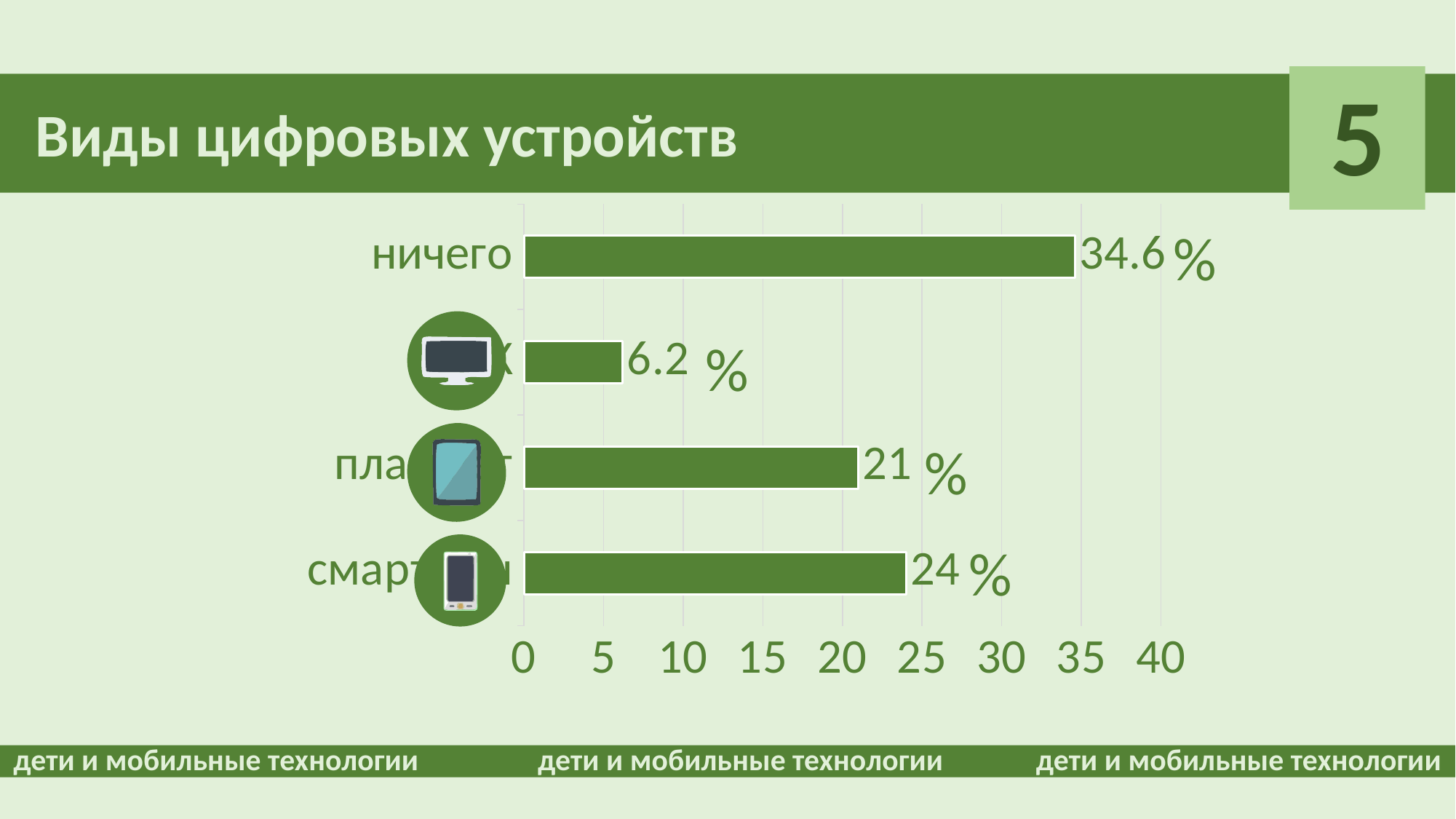
What is the difference between the values for смартфон and планшет? 3 % What is the value of the second bar from the top (the one with the computer monitor icon)? 6.2 % How many bars are shown on the chart? 4 What is the value for смартфон? 24 % What is the value for планшет? 21 % What is the lowest value shown on the chart? 6.2 % Which category has the highest value? ничего What is the value for ничего? 34.6 % Which is larger, the value for планшет or the value for смартфон? смартфон What is the title of the slide? Виды цифровых устройств What kind of chart is shown on the slide? bar chart What is the difference between the values for ничего and смартфон? 10.6 %